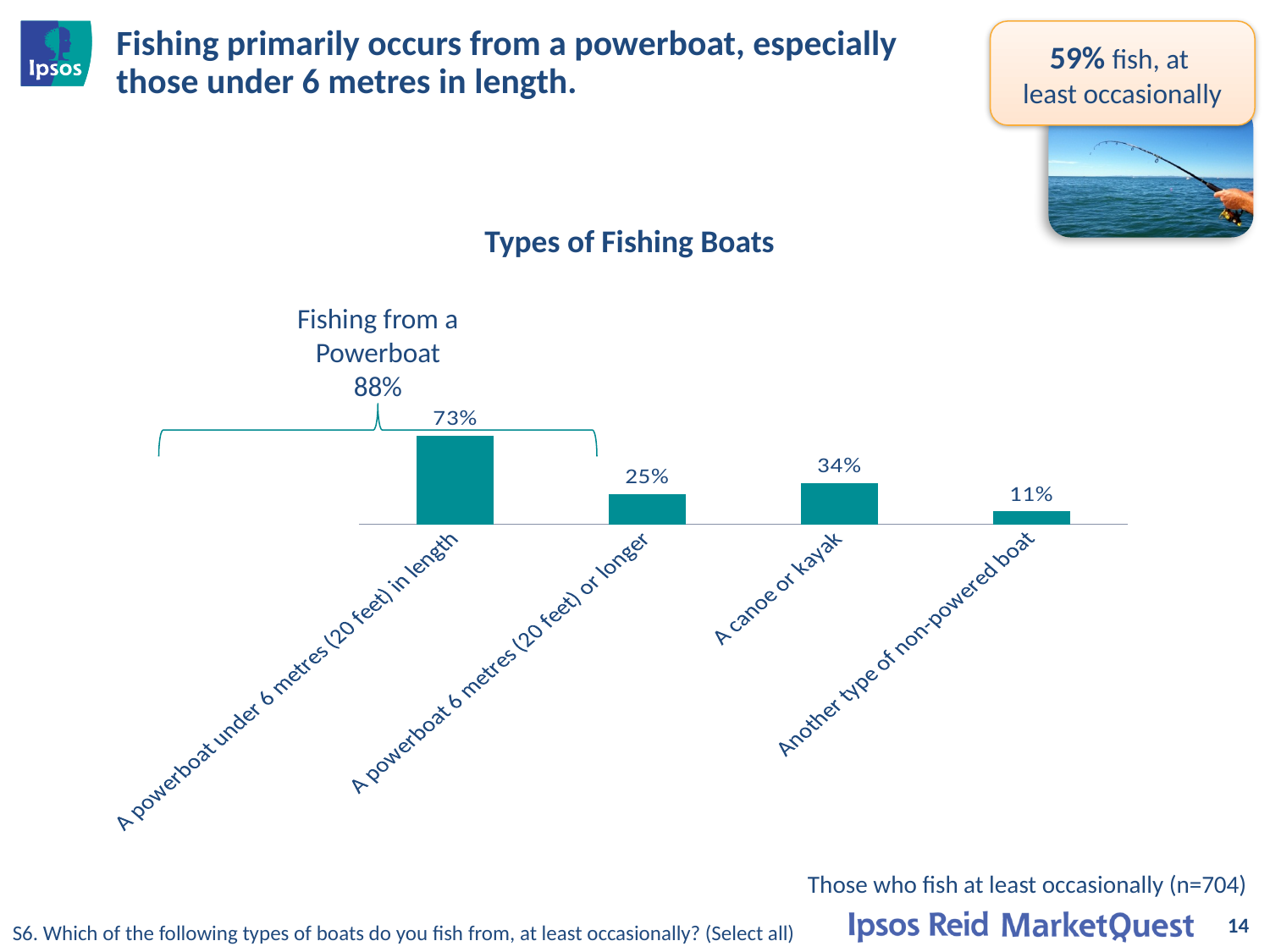
What is the title of the chart? Types of Fishing Boats What is the value for 'A powerboat 6 metres (20 feet) or longer'? 25% What combined value is shown for 'Fishing from a Powerboat' above the bracket? 88% What is the value for 'Another type of non-powered boat'? 11% Which category has the lowest value? Another type of non-powered boat How many categories are shown in the chart? 4 What is the value for 'A powerboat under 6 metres (20 feet) in length'? 73% What is the value for 'A canoe or kayak'? 34% What is the difference between the values for 'A powerboat under 6 metres (20 feet) in length' and 'A canoe or kayak'? 39% Which category has the highest value? A powerboat under 6 metres (20 feet) in length What kind of chart is shown? Bar chart Which is larger: the value for 'A canoe or kayak' or 'A powerboat 6 metres (20 feet) or longer'? A canoe or kayak